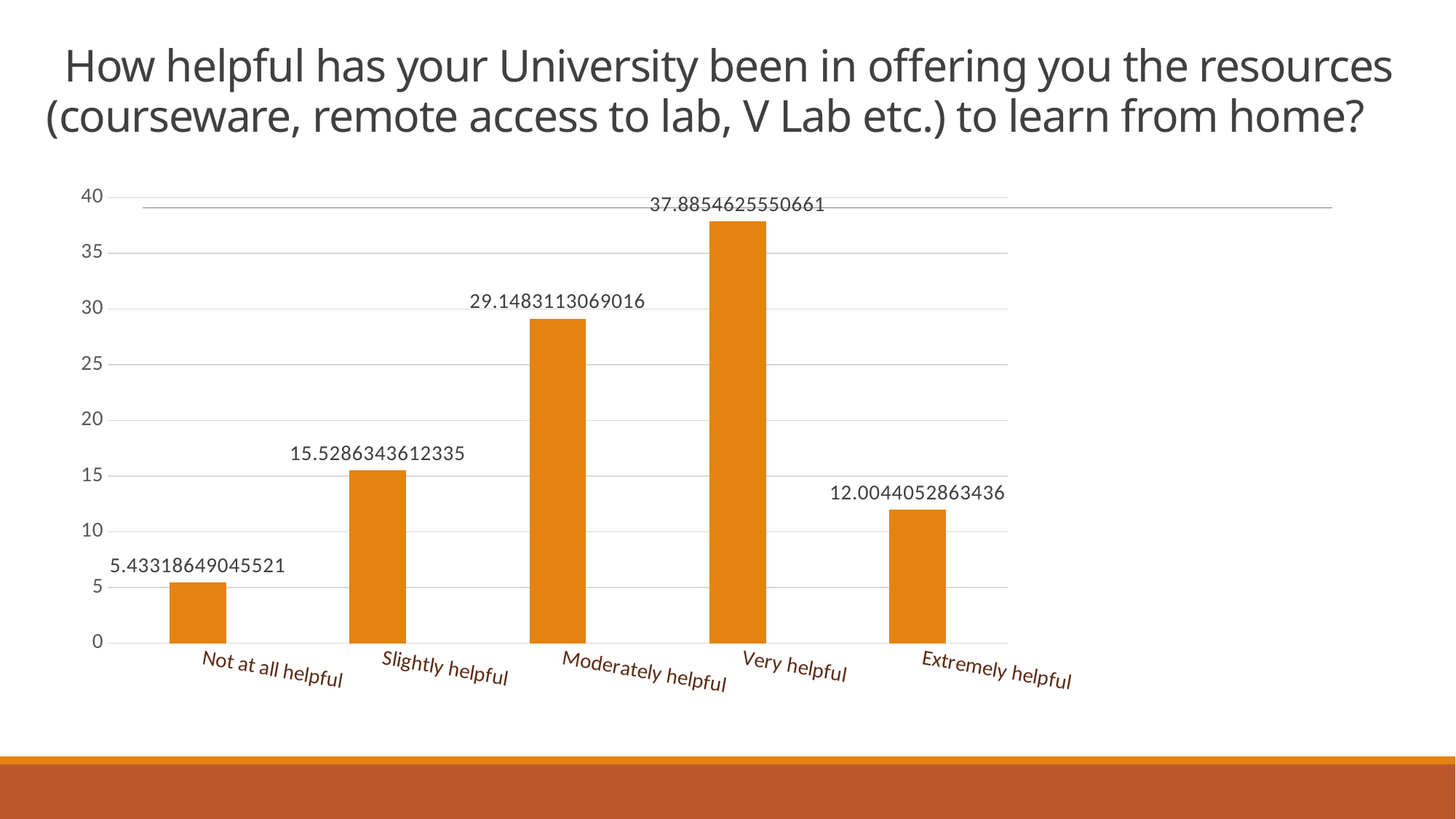
What is the value for "Very helpful"? 37.8854625550661 What is the difference between the values for "Very helpful" and "Moderately helpful"? 8.7371512481645 What type of chart is shown on the slide? bar chart How many categories are shown on the x axis of the chart? 5 Which category has the lowest value? Not at all helpful Is the value for "Extremely helpful" greater or less than 10? greater What is the value for "Not at all helpful"? 5.43318649045521 What is the value for "Slightly helpful"? 15.5286343612335 Which category has the highest value? Very helpful What is the highest tick value shown on the vertical axis? 40 What is the value for "Extremely helpful"? 12.0044052863436 Which is larger, the value for "Moderately helpful" or the value for "Extremely helpful"? Moderately helpful